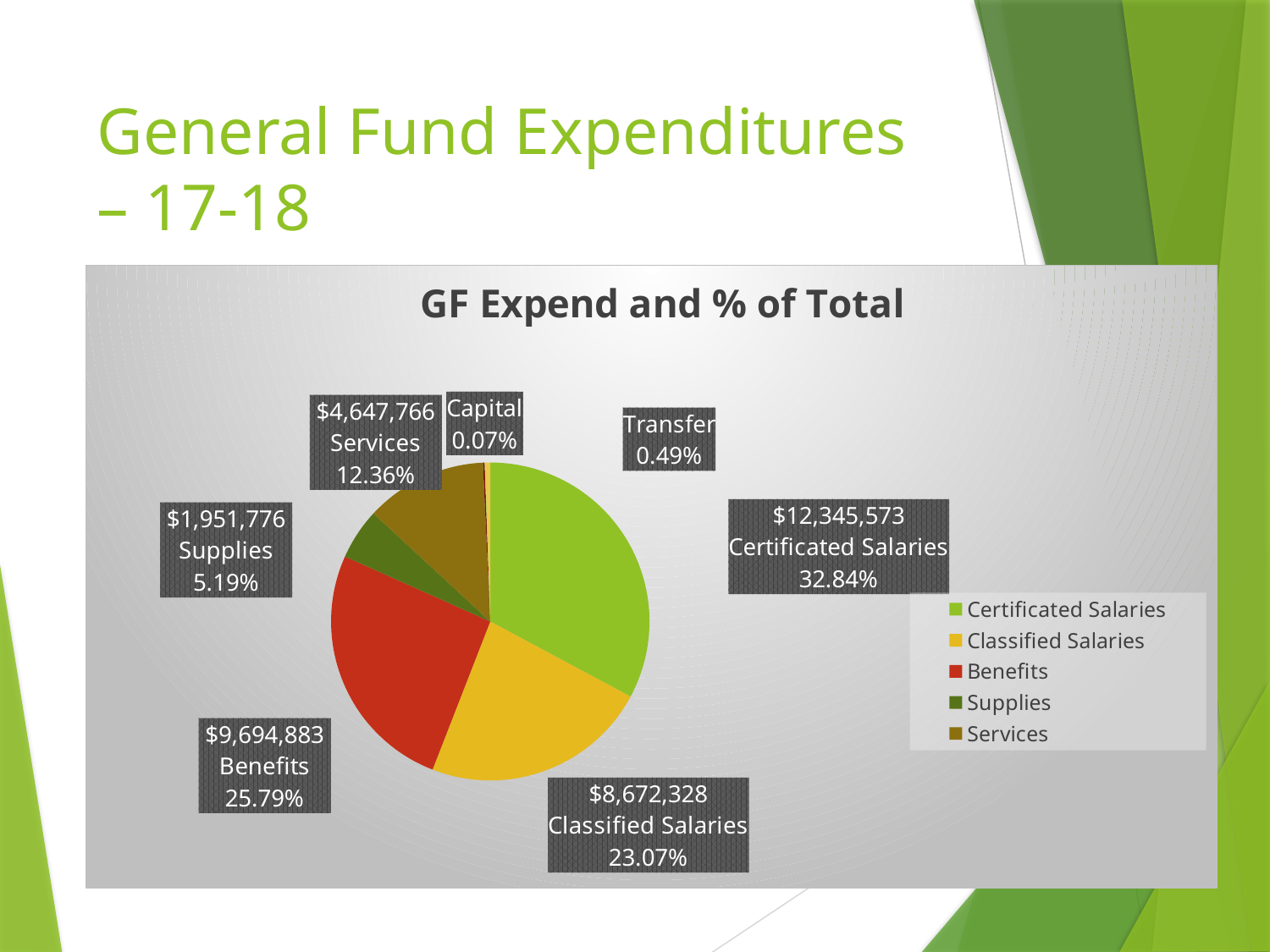
Which category has the largest share of the pie? Certificated Salaries What type of chart is shown on the slide? Pie chart What percentage of the total is Services? 12.36% Which category has the smallest share of the pie? Capital How many categories are labelled on the pie chart? 7 What is the title of the chart? GF Expend and % of Total What is the difference in dollars between Certificated Salaries and Classified Salaries? $3,673,245 What is the dollar value shown for Certificated Salaries? $12,345,573 How many entries does the legend list? 5 What percentage of the total is Benefits? 25.79% What is the dollar value shown for Classified Salaries? $8,672,328 Which is larger, Benefits or Classified Salaries? Benefits